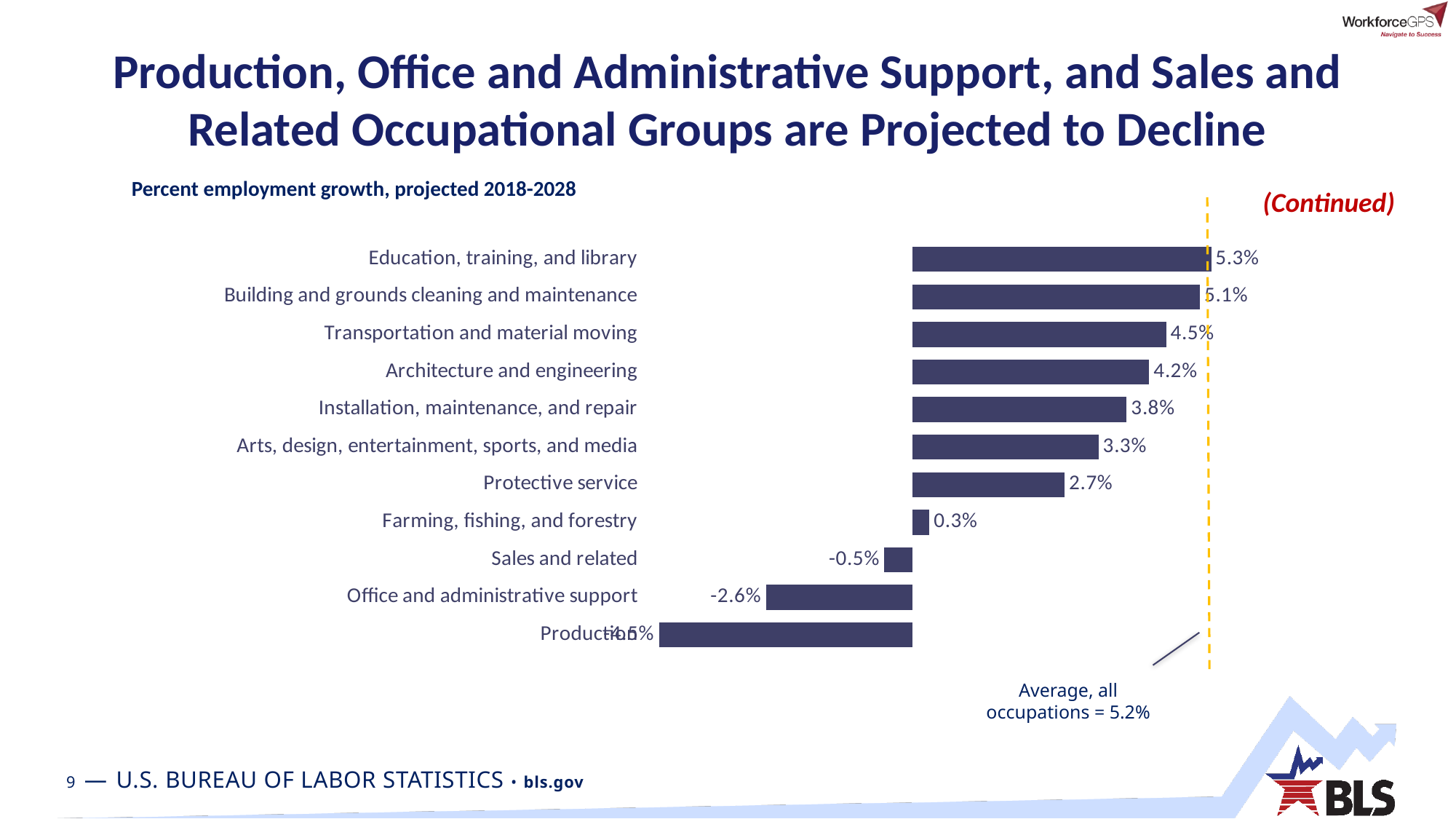
Which occupational group has the lowest projected percent employment growth? Production What is the difference between the projected growth for Installation, maintenance, and repair and Arts, design, entertainment, sports, and media? 0.5% What is the projected percent employment growth for Office and administrative support? -2.6% Which has a higher projected growth: Building and grounds cleaning and maintenance or Transportation and material moving? Building and grounds cleaning and maintenance What is the projected percent employment growth for Protective service? 2.7% What value does the dashed line labeled 'Average, all occupations' represent? 5.2% Which occupational group has the highest projected percent employment growth? Education, training, and library What is the projected percent employment growth for Farming, fishing, and forestry? 0.3% What is the difference between the projected growth for Transportation and material moving and Architecture and engineering? 0.3% What type of chart is shown on the slide? Bar chart How many occupational groups are shown in the chart? 11 What is the projected percent employment growth for Education, training, and library? 5.3%